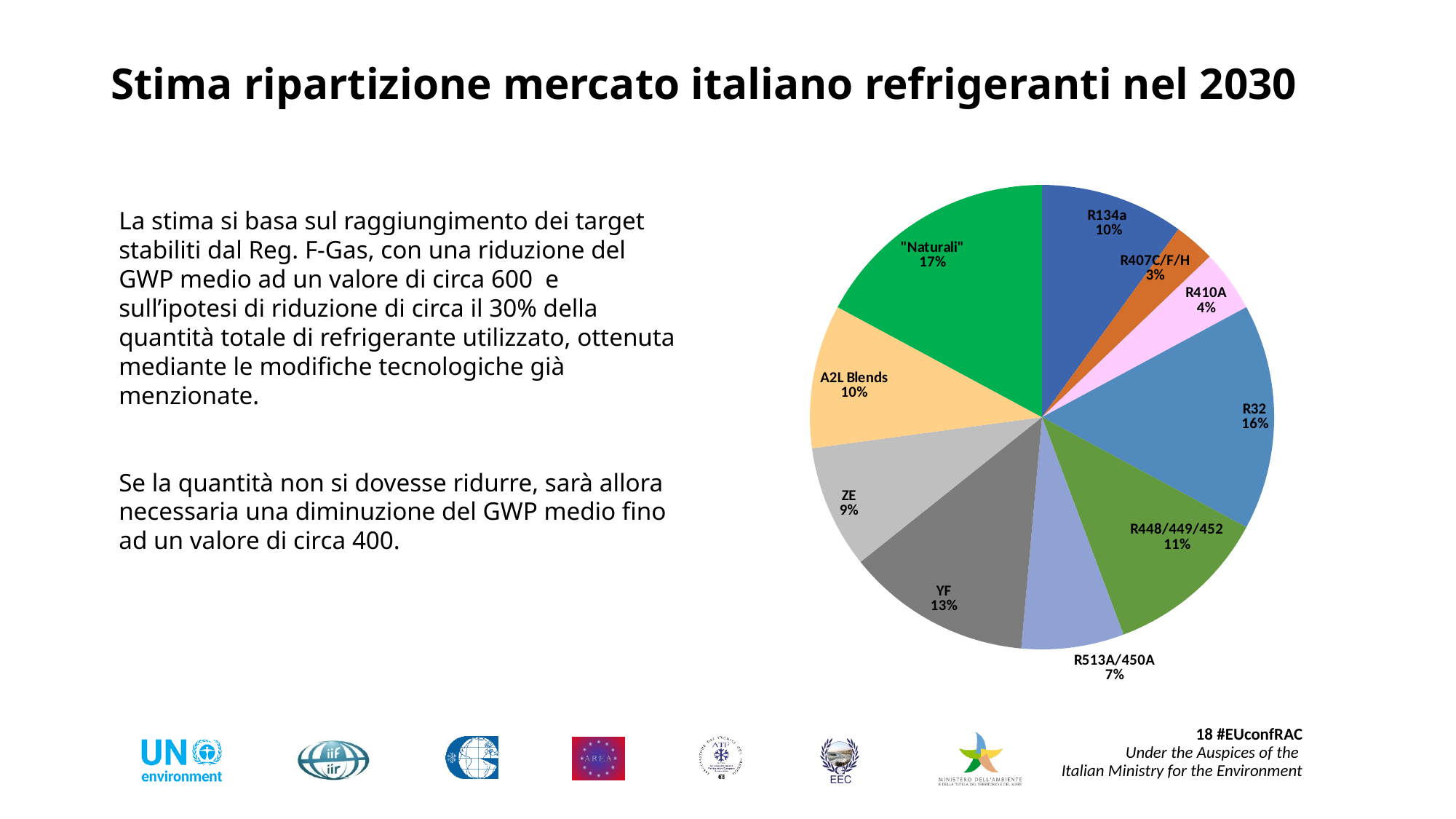
Which two categories both have a share of 10%? R134a and A2L Blends What share of the pie does "Naturali" represent? 17% Which category has the smallest slice of the pie? R407C/F/H What is the value shown for YF? 13% Which is larger, the share for R448/449/452 or the share for ZE? R448/449/452 What is the value shown for R407C/F/H? 3% What is the title of the slide containing the pie chart? Stima ripartizione mercato italiano refrigeranti nel 2030 Which category has the largest slice of the pie? "Naturali" How many slices does the pie chart have? 10 What type of chart is shown on the slide? pie chart What share of the pie does R32 represent? 16% What is the difference between the shares of R32 and R410A? 12%